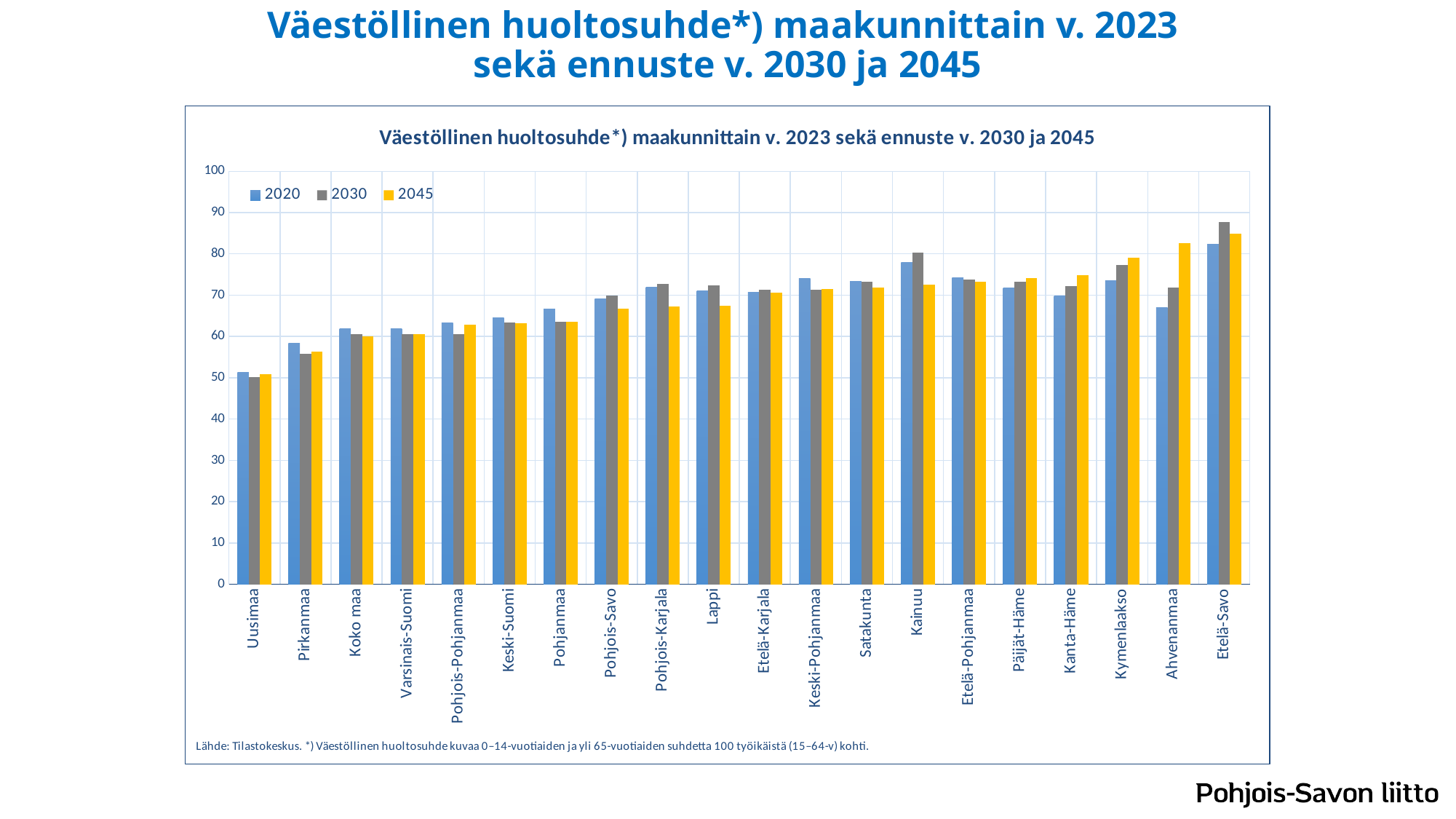
Is the 2020 value for Pirkanmaa greater or less than 60? less For Ahvenanmaa, which is larger: the 2020 value or the 2045 value? 2045 What kind of chart is shown on the slide? bar chart Do the 2020 values generally rise or fall from left to right along the x axis? rise For Kainuu, which is larger: the 2030 value or the 2045 value? 2030 Is the 2045 value for Pohjois-Savo greater or less than 70? less Which region has the lowest value for the 2030 series? Uusimaa How many series does the legend list? 3 Which region has the highest value for the 2030 series? Etelä-Savo Is the 2045 value for Ahvenanmaa greater or less than 80? greater How many regions (categories) are shown on the x axis? 20 Which region has the highest value for the 2045 series? Etelä-Savo